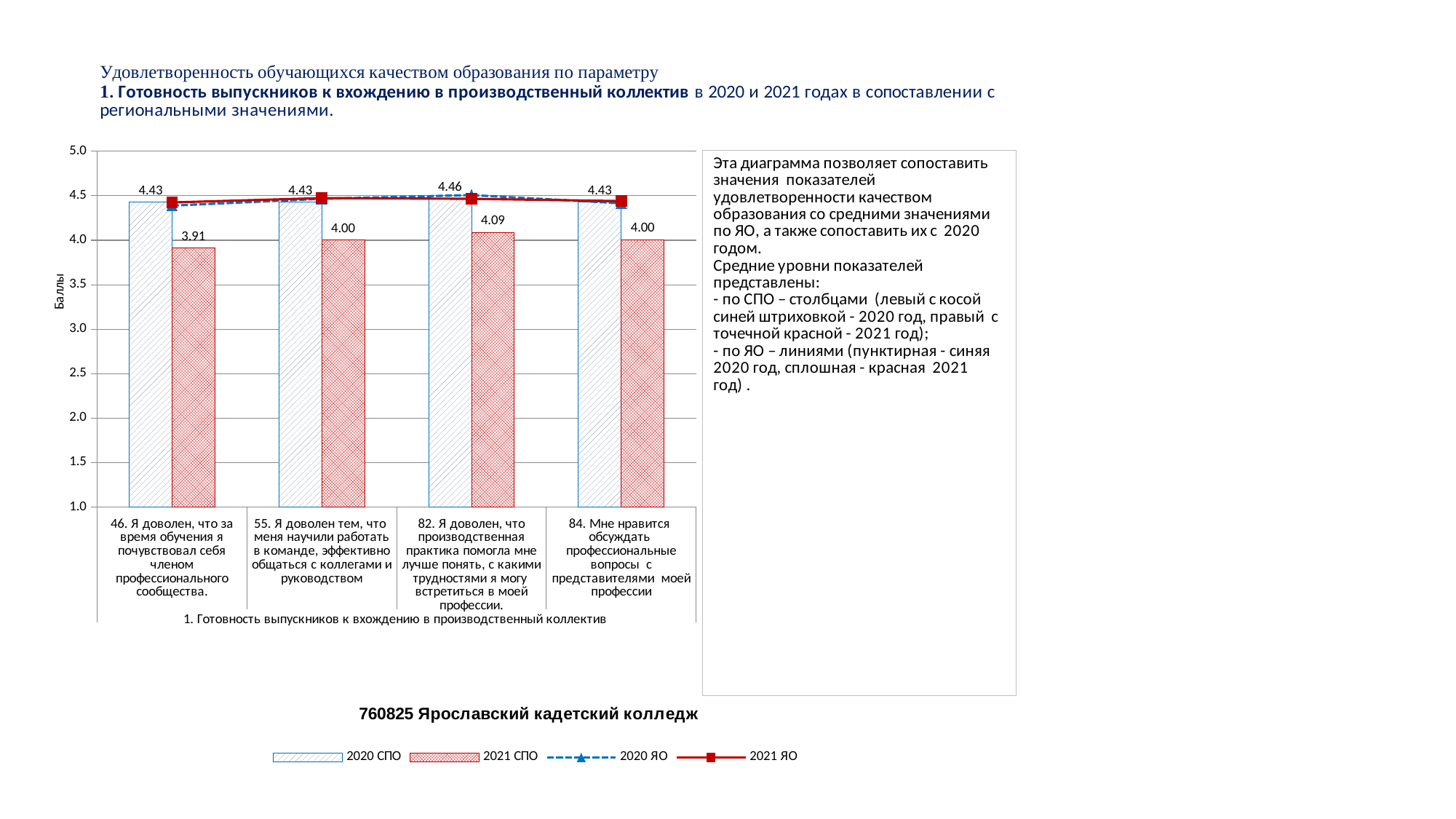
Which category has the lowest 2021 СПО value? 46. Я доволен, что за время обучения я почувствовал себя членом профессионального сообщества. Which category has the highest 2020 СПО value? 82. Я доволен, что производственная практика помогла мне лучше понять, с какими трудностями я могу встретиться в моей профессии. Is the 2021 СПО value for category 46 greater or less than 4.0? less What is the 2021 СПО value for category 82 (Я доволен, что производственная практика помогла мне лучше понять...)? 4.09 What is the label of the vertical axis? Баллы How many categories (questions) are shown on the x axis? 4 What is the 2020 СПО value for category 46 (Я доволен, что за время обучения я почувствовал себя членом профессионального сообщества)? 4.43 For category 55, which is larger: the 2020 СПО value or the 2021 СПО value? 2020 СПО How many series does the legend list? 4 What is the 2021 СПО value for category 46? 3.91 What is the difference between the 2020 СПО and 2021 СПО values for category 82? 0.37 What is the difference between the 2020 СПО and 2021 СПО values for category 46? 0.52